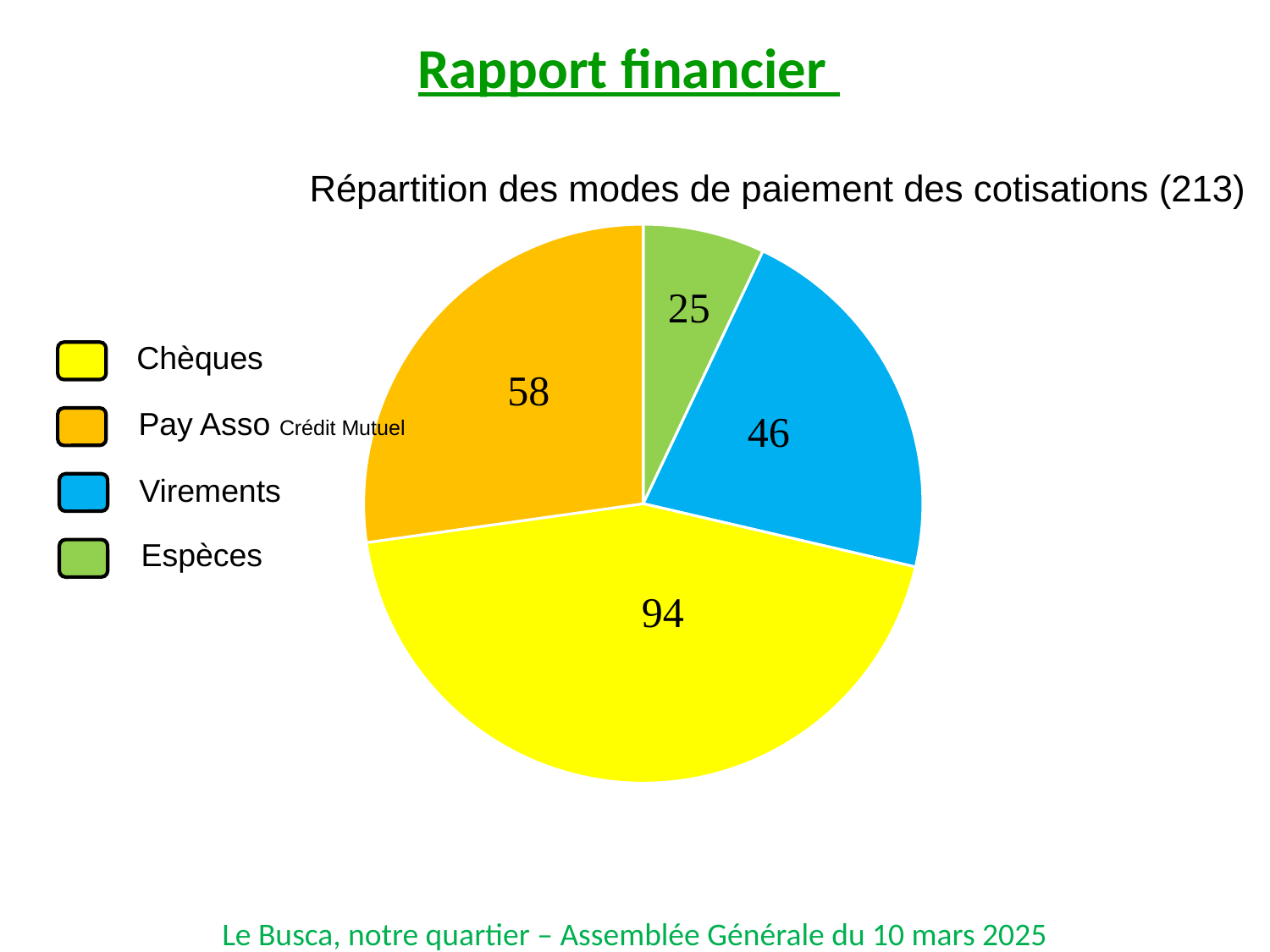
Which payment mode has the largest slice? Chèques What is the title of the pie chart? Répartition des modes de paiement des cotisations (213) How many slices does the pie chart have? 4 What is the value for Virements? 46 What is the difference between the values for Chèques and Pay Asso Crédit Mutuel? 36 What kind of chart is shown on the slide? pie chart What is the value for Espèces? 25 What is the value for Pay Asso Crédit Mutuel? 58 What is the value for Chèques? 94 Which is larger, Virements or Espèces? Virements Which payment mode has the smallest slice? Espèces